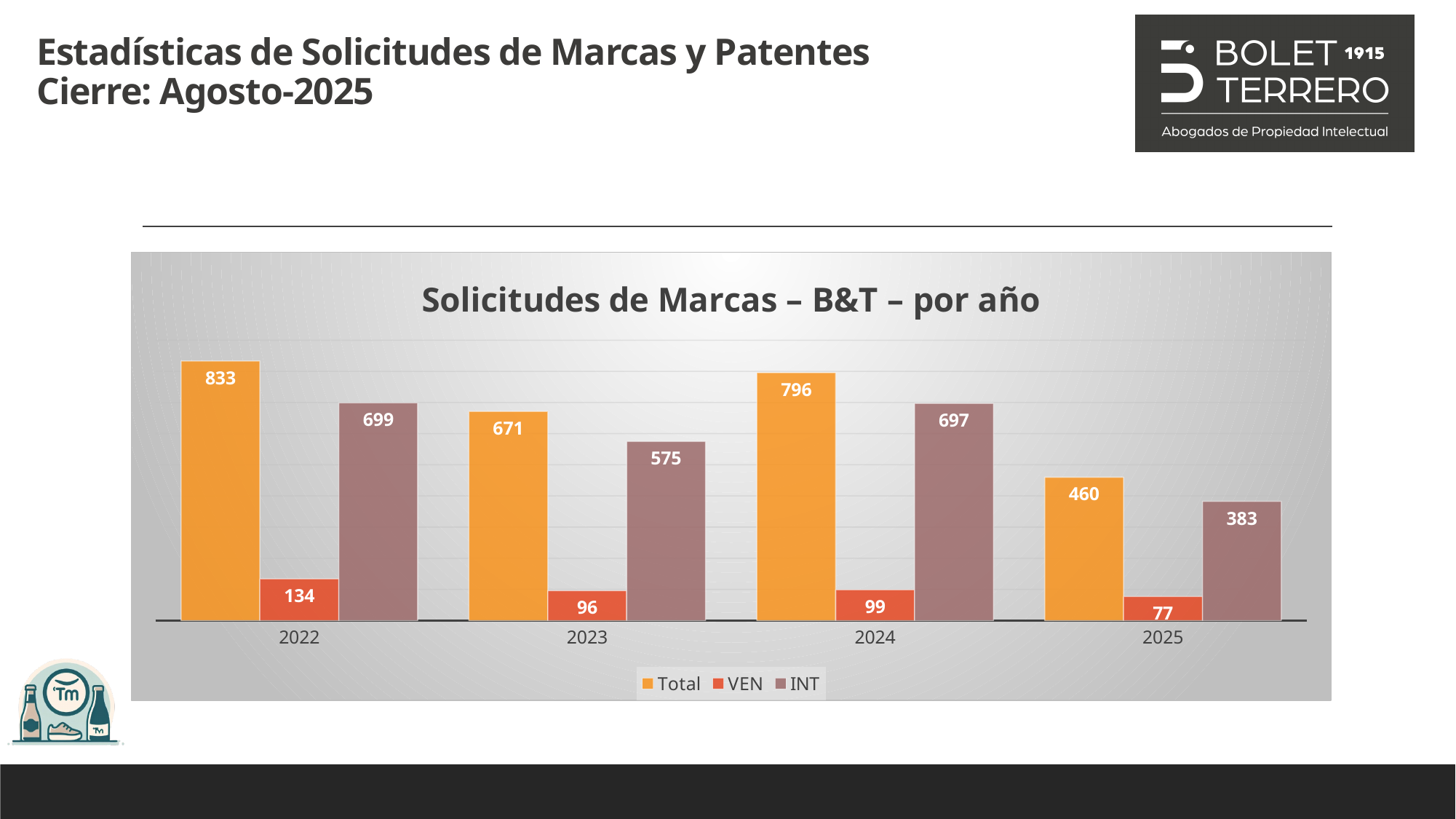
Which is larger, the INT value for 2022 or the INT value for 2024? INT for 2022 What is the title of the chart? Solicitudes de Marcas – B&T – por año What is the VEN value for 2025? 77 What is the INT value for 2023? 575 Which year has the highest Total value? 2022 What kind of chart is shown? Bar chart Does the VEN value rise or fall from 2024 to 2025? Fall How many years are shown on the x axis? 4 What is the Total value for 2022? 833 Which year has the lowest INT value? 2025 How many series does the legend list? 3 What is the difference between the Total values for 2022 and 2023? 162